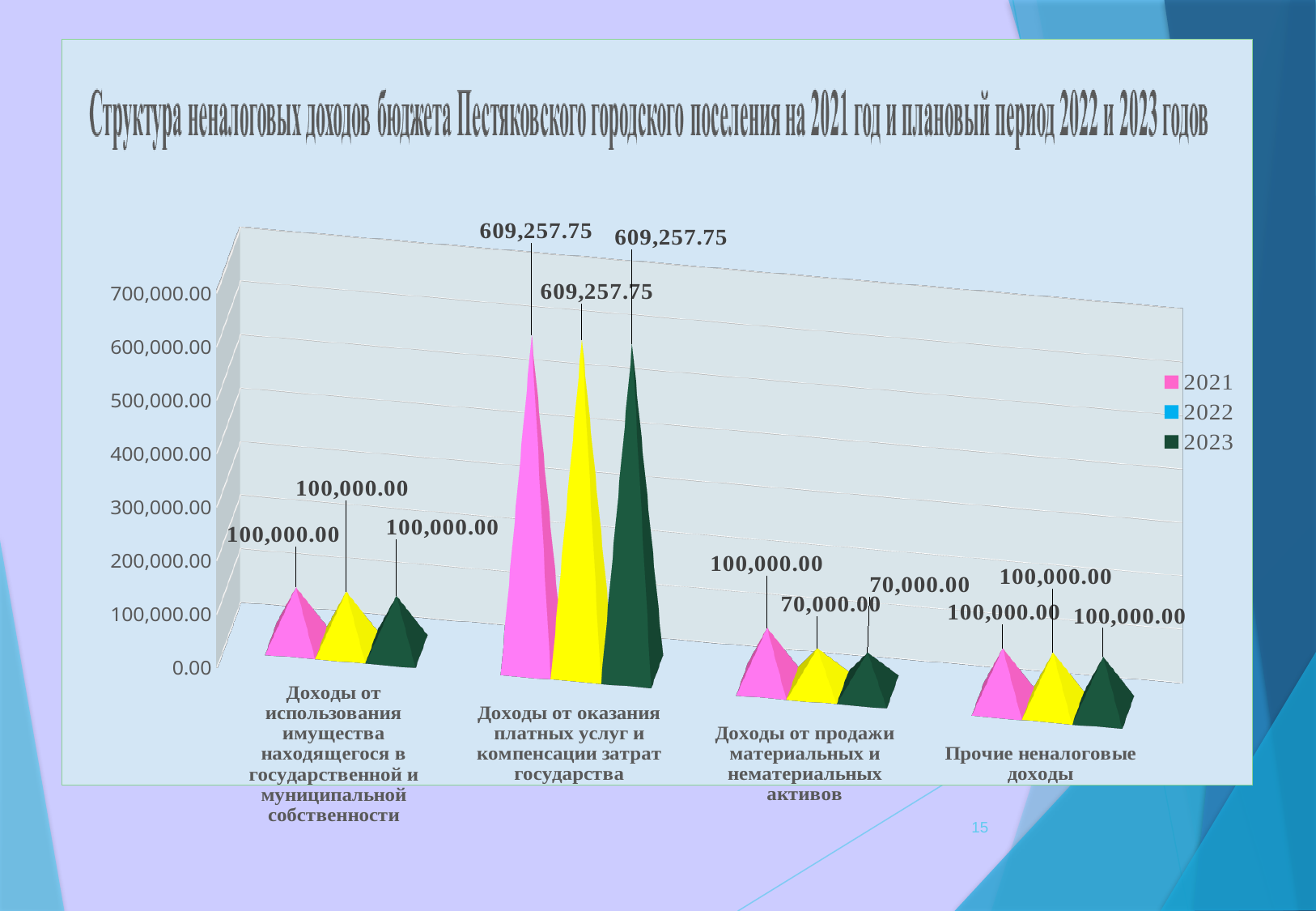
Which category has the lowest value for 2022? Доходы от продажи материальных и нематериальных активов Is the 2022 value for "Доходы от оказания платных услуг и компенсации затрат государства" greater or less than 500,000.00? greater Which is larger: the 2021 value for "Доходы от оказания платных услуг и компенсации затрат государства" or the 2021 value for "Прочие неналоговые доходы"? Доходы от оказания платных услуг и компенсации затрат государства What is the difference between the 2021 and 2023 values for "Доходы от продажи материальных и нематериальных активов"? 30,000.00 What is the value for 2023 for "Доходы от использования имущества находящегося в государственной и муниципальной собственности"? 100,000.00 What is the value for 2022 for "Доходы от продажи материальных и нематериальных активов"? 70,000.00 What kind of chart is shown on the slide? bar chart Which category has the highest value for 2023? Доходы от оказания платных услуг и компенсации затрат государства What is the value for 2021 for "Доходы от оказания платных услуг и компенсации затрат государства"? 609,257.75 What is the value for 2021 for "Прочие неналоговые доходы"? 100,000.00 How many categories are shown on the x axis? 4 How many series does the legend list? 3